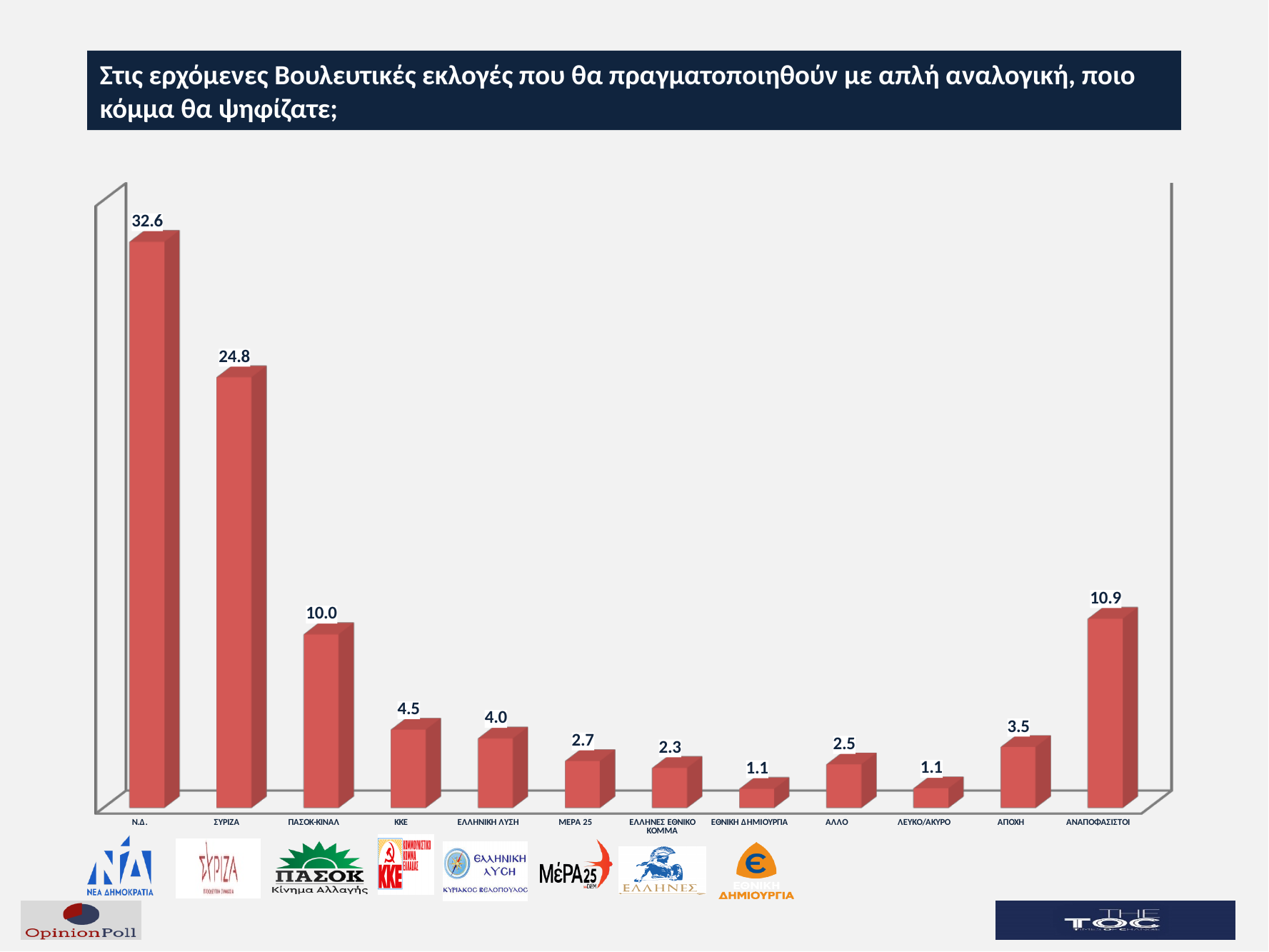
What kind of chart is shown on the slide? Bar chart What value is shown for ΚΚΕ? 4.5 What value is shown for ΑΠΟΧΗ? 3.5 What value is shown for Ν.Δ.? 32.6 How many categories are shown in the chart? 12 Which is larger, the value for ΑΛΛΟ or the value for ΕΛΛΗΝΕΣ ΕΘΝΙΚΟ ΚΟΜΜΑ? ΑΛΛΟ What is the difference between the values for Ν.Δ. and ΣΥΡΙΖΑ? 7.8 Which category has the highest value? Ν.Δ. What value is shown for ΣΥΡΙΖΑ? 24.8 What is the difference between the values for ΑΝΑΠΟΦΑΣΙΣΤΟΙ and ΠΑΣΟΚ-ΚΙΝΑΛ? 0.9 Which is larger, the value for ΕΛΛΗΝΙΚΗ ΛΥΣΗ or the value for ΜΕΡΑ 25? ΕΛΛΗΝΙΚΗ ΛΥΣΗ What value is shown for ΑΝΑΠΟΦΑΣΙΣΤΟΙ? 10.9